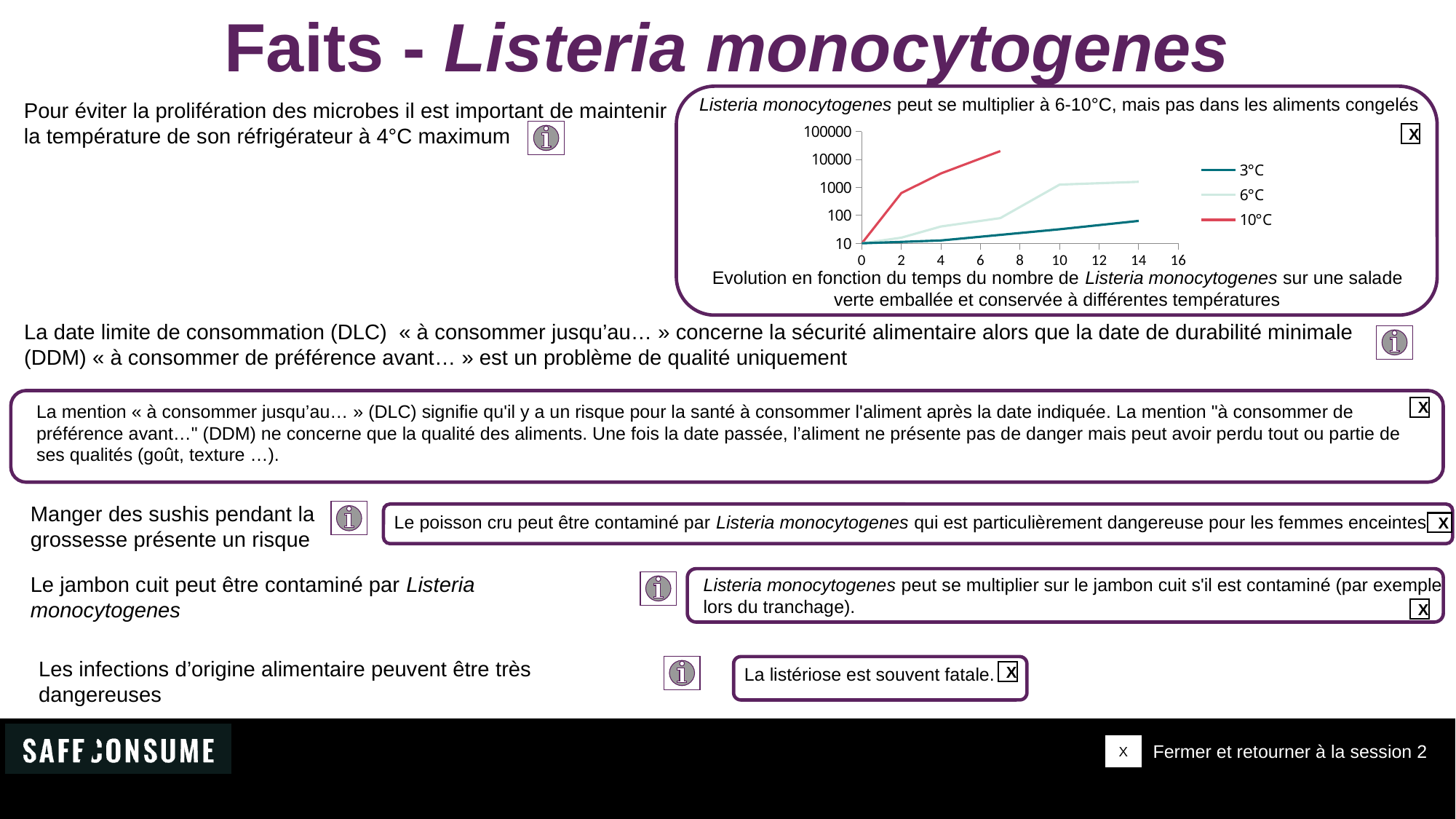
Is the value for the 10°C series at x = 7 greater or less than 1000? greater Do the values of the 10°C series rise or fall along the x axis? rise At x = 6, which series has the larger value, 10°C or 3°C? 10°C What are the three series listed in the chart legend? 3°C, 6°C, 10°C What is the highest tick value shown on the chart's y axis? 100000 Which series stays the lowest across the chart? 3°C Which series reaches the highest value on the chart? 10°C What kind of chart is shown on the slide? line chart Is the value for the 6°C series at x = 14 greater or less than 100? greater Is the value for the 3°C series at x = 14 greater or less than 1000? less How many series does the chart legend list? 3 At x = 10, which series has the larger value, 6°C or 3°C? 6°C